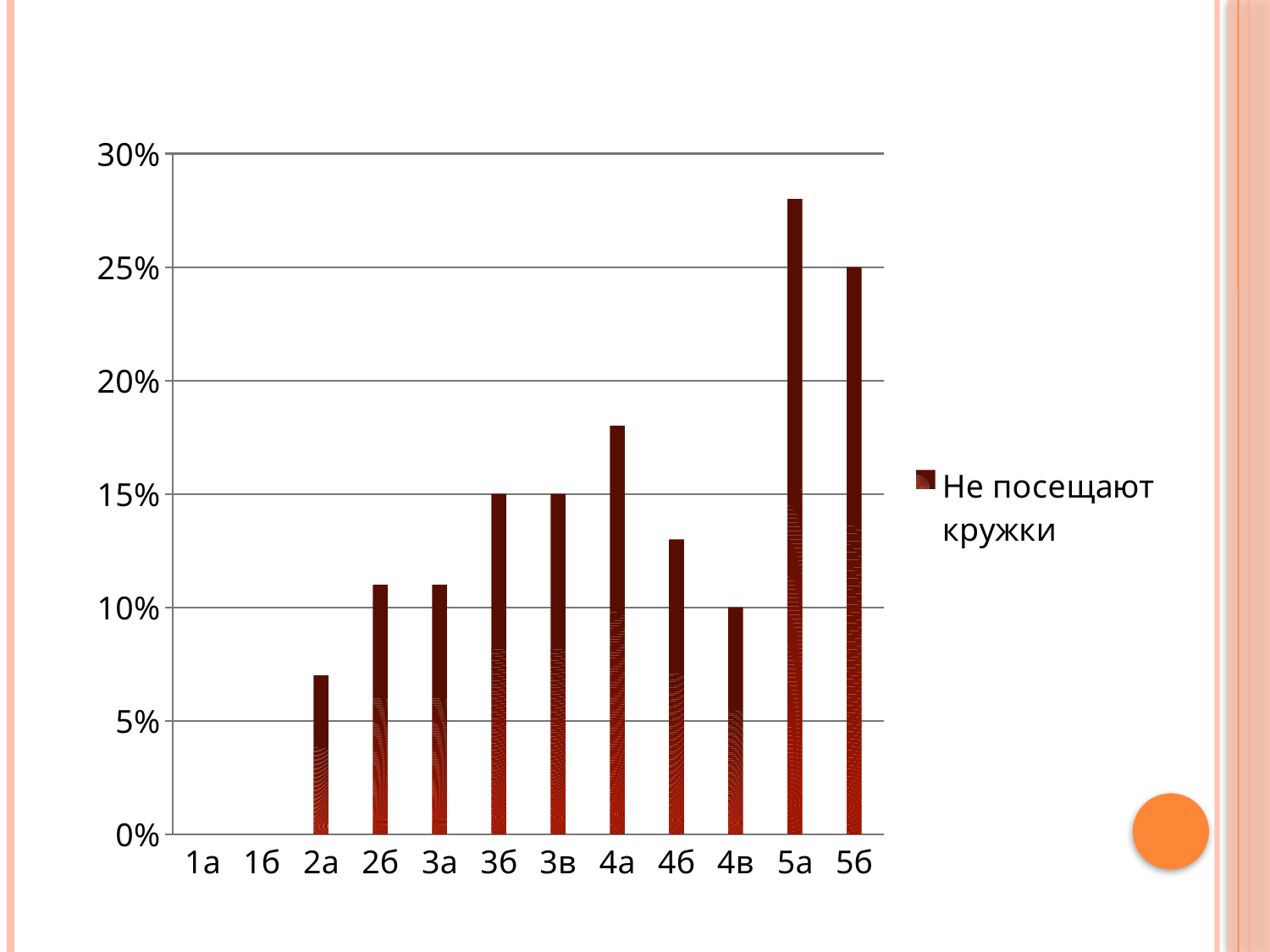
What is the value for 5б? 25% Which is larger, the value for 4а or the value for 4б? 4а Is the value for 2а greater or less than 10%? less What is the value for 3б? 15% How many series does the legend list? 1 Do the values generally rise or fall from 2а to 5б along the x axis? rise What kind of chart is shown on the slide? bar chart Which category has the highest value in the chart? 5а What is the value for 4в? 10% What is the legend entry for the series in the chart? Не посещают кружки How many categories are shown on the x axis of the chart? 12 Is the value for 5а greater or less than 25%? greater